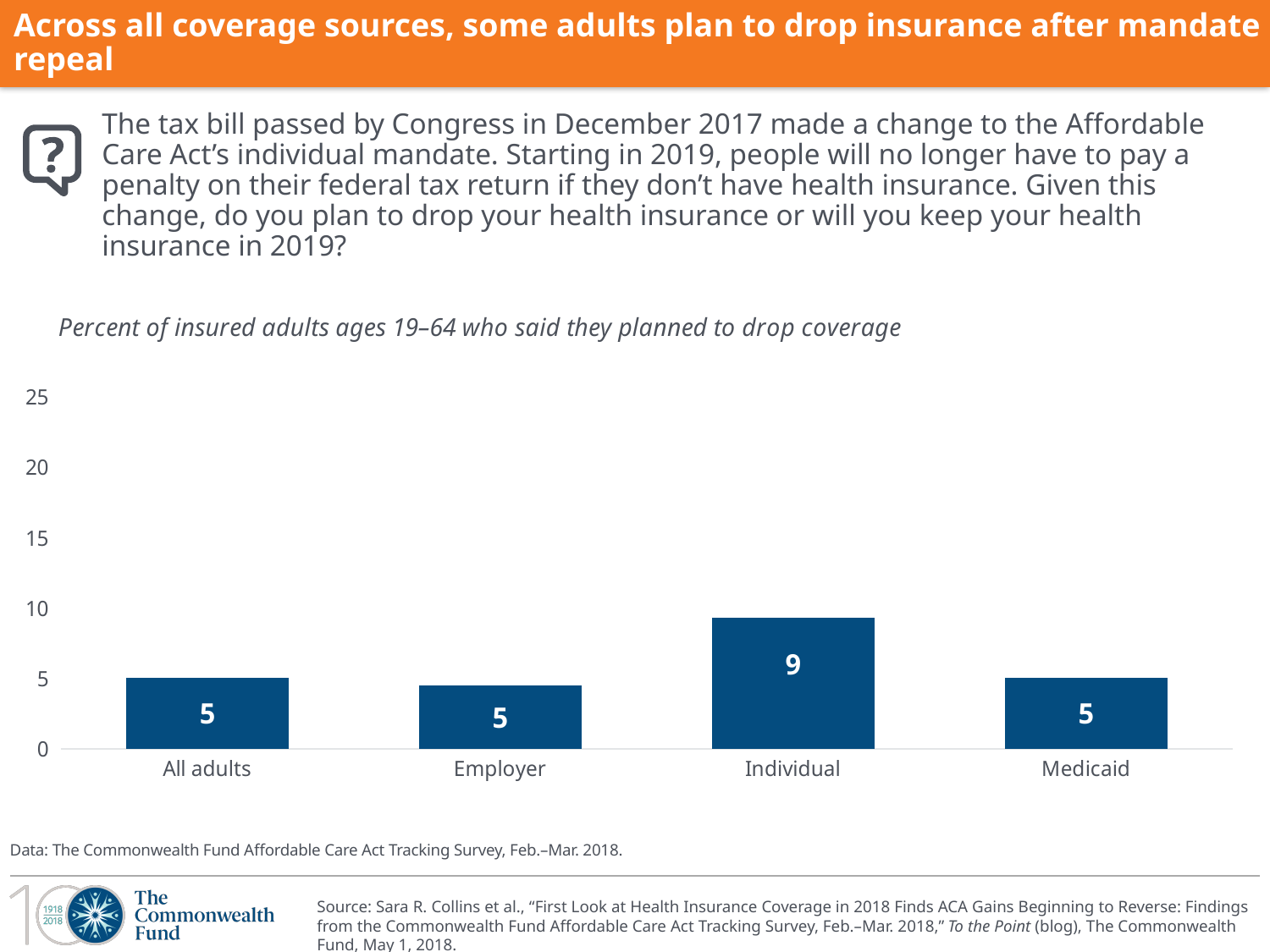
What is the highest value labeled on the y axis? 25 What is the value shown for All adults? 5 What percent of adults with individual coverage said they planned to drop coverage? 9 Which coverage source has the highest percent of adults planning to drop coverage? Individual What is the value shown for Medicaid? 5 What is the difference between the Individual value and the Employer value? 4 How many categories are shown on the x axis of the chart? 4 What is the subtitle describing what the chart measures? Percent of insured adults ages 19–64 who said they planned to drop coverage What is the value shown for Employer? 5 Which is larger, the value for Individual or the value for Medicaid? Individual Is the value for Individual greater or less than 10? less What kind of chart is shown on the slide? Bar chart